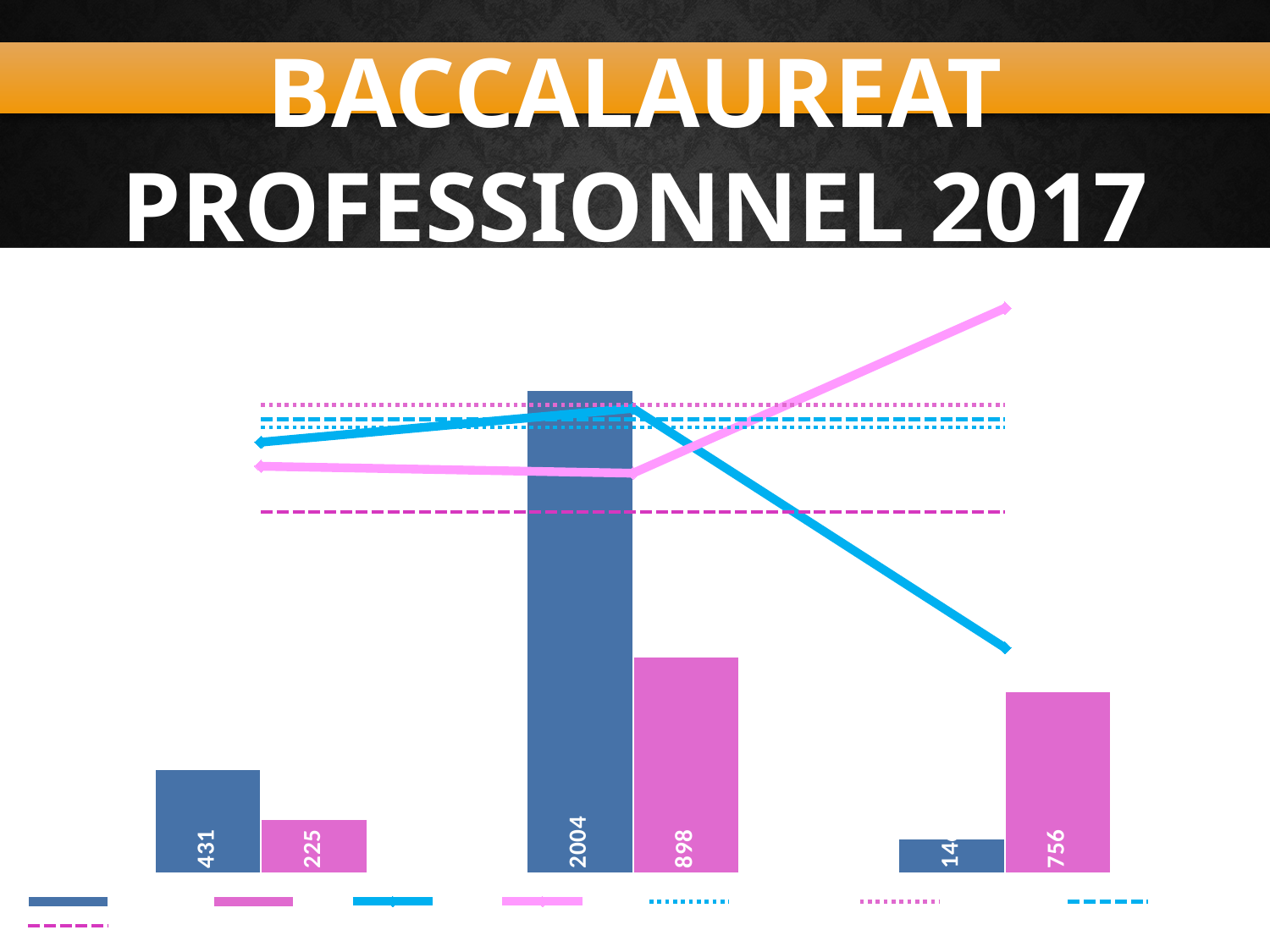
Does the solid blue line rise or fall between the middle point and the rightmost point? Fall What is the value of the pink bar in the third (rightmost) group? 756 Which group has the tallest blue bar? The middle group How many groups of bars are plotted on the chart? 3 What is the value of the blue bar in the middle group? 2004 What is the value of the pink bar in the first (leftmost) group? 225 What is the difference between the blue bar and the pink bar in the middle group? 1106 What is the title of the slide containing the chart? BACCALAUREAT PROFESSIONNEL 2017 What is the difference between the blue bar and the pink bar in the first group? 206 What is the value of the blue bar in the first (leftmost) group? 431 In the first group, which bar is larger, the blue bar or the pink bar? The blue bar What is the value of the pink bar in the middle group? 898